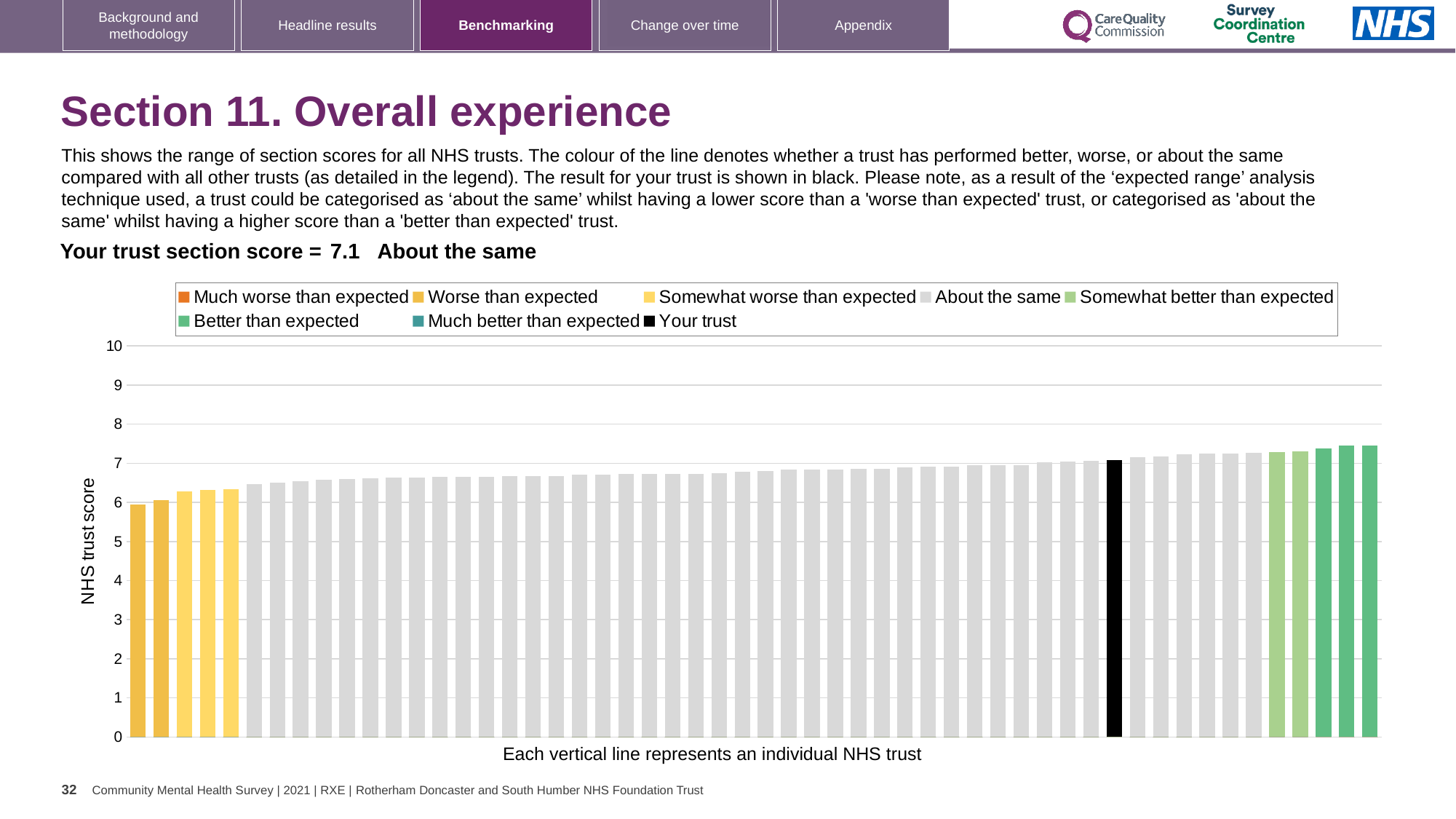
What kind of chart is shown on the slide? bar chart Which performance category is your trust placed in for Section 11? About the same Which is larger: the black 'Your trust' bar or the leftmost bar in the chart? the black 'Your trust' bar Is the value of the black 'Your trust' bar greater or less than 5? greater Is the value of the tallest bar in the chart greater or less than 8? less Which legend category do the tallest bars on the right of the chart belong to? Better than expected What colour is used for the bar representing your trust? black What is the label on the vertical axis of the chart? NHS trust score Do the bar values rise or fall moving from left to right along the x axis? rise What is the section score for your trust shown on the slide? 7.1 Is the value of the leftmost (lowest) bar greater or less than 7? less How many entries does the chart legend list? 8